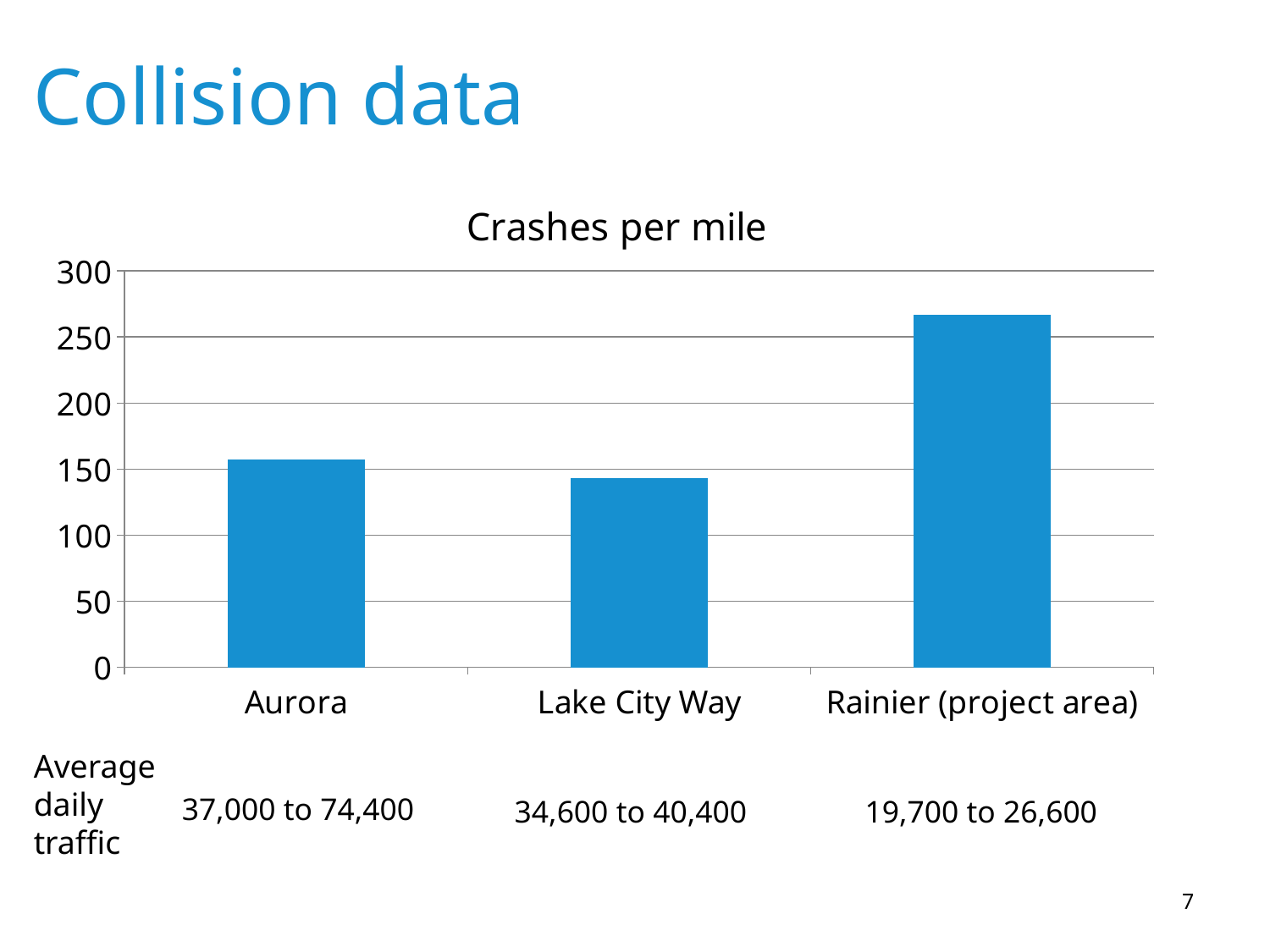
What is the title of the chart? Crashes per mile Is the value for Rainier (project area) greater or less than 250? greater Is the value for Lake City Way greater or less than 100? greater Which category has the highest crashes per mile? Rainier (project area) How many categories are plotted in the chart? 3 Which category has the lowest crashes per mile? Lake City Way Which has more crashes per mile, Rainier (project area) or Aurora? Rainier (project area) What kind of chart is shown on the slide? bar chart Which has more crashes per mile, Aurora or Lake City Way? Aurora Is the value for Aurora greater or less than 200? less What is the average daily traffic range listed for Rainier (project area)? 19,700 to 26,600